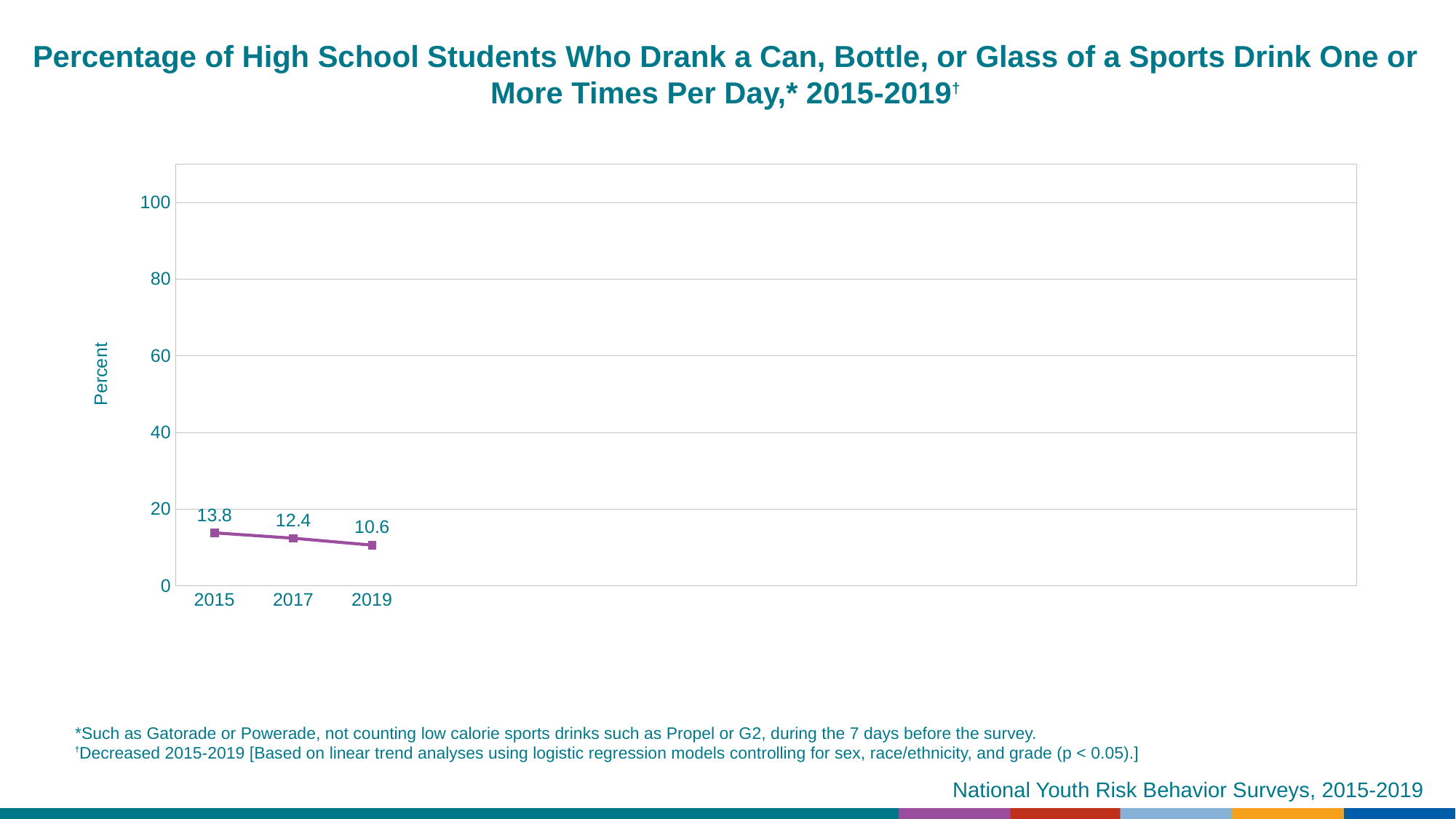
What percentage of high school students drank a sports drink one or more times per day in 2015? 13.8 Which year has the lowest percentage? 2019 Is the value for 2015 greater or less than 20? less How many years are plotted on the chart? 3 What is the value plotted for 2017? 12.4 Which year has the highest percentage? 2015 Do the values rise or fall from 2015 to 2019? fall Which is larger, the value for 2017 or the value for 2019? 2017 What is the difference between the 2015 and 2019 values? 3.2 What kind of chart is shown on the slide? line chart What is the difference between the 2015 and 2017 values? 1.4 What is the value plotted for 2019? 10.6